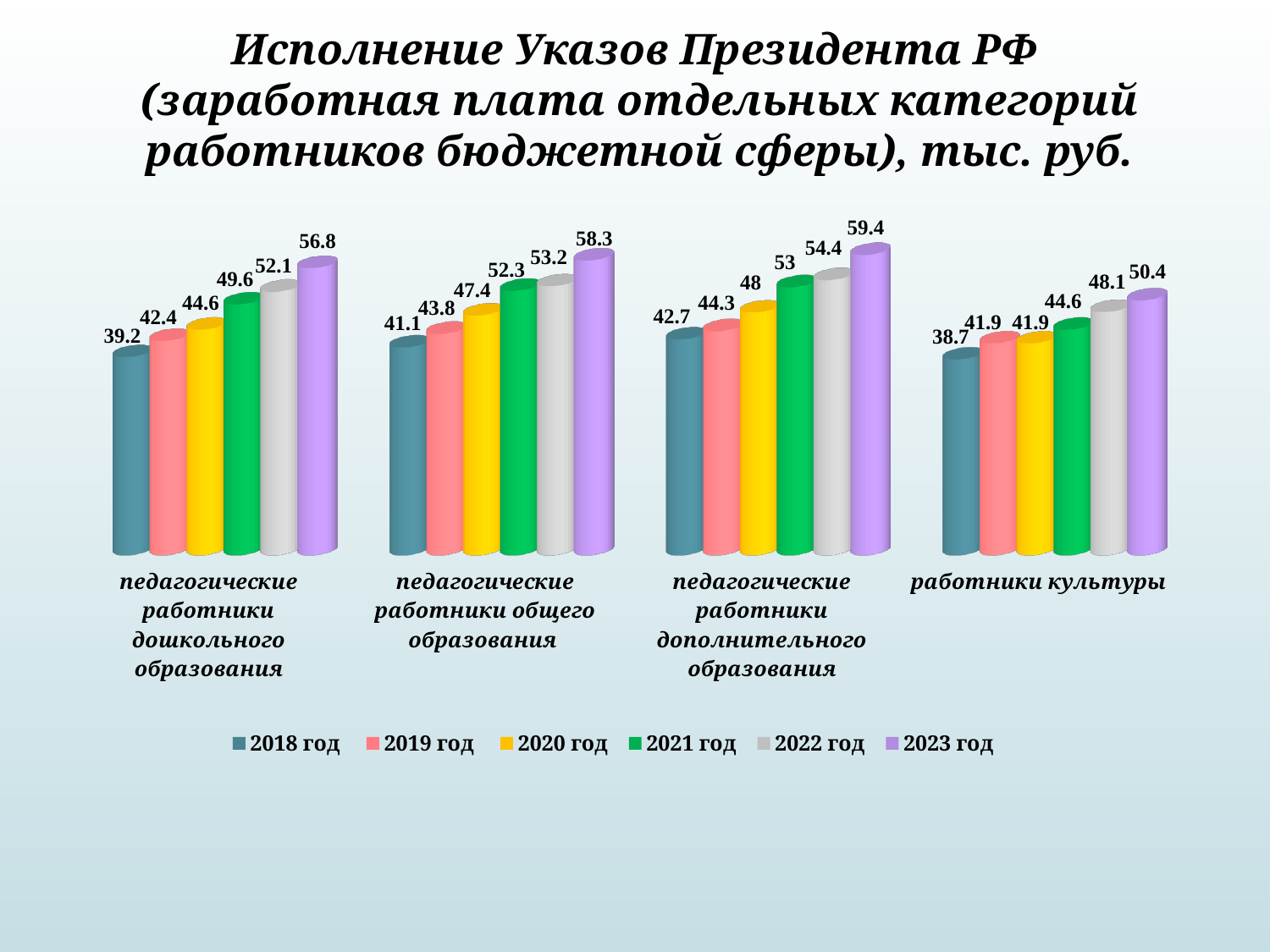
У какой категории работников самое низкое значение за 2018 год? работники культуры Что больше: значение для педагогических работников общего образования за 2022 год или для педагогических работников дошкольного образования за 2022 год? педагогические работники общего образования Какое значение показано для педагогических работников дошкольного образования за 2018 год? 39.2 Как меняются значения для работников культуры с 2018 по 2023 год — растут или падают? растут Сколько рядов (годов) перечислено в легенде диаграммы? 6 Какое значение показано для работников культуры за 2023 год? 50.4 Какое значение показано для педагогических работников общего образования за 2021 год? 52.3 У какой категории работников самое высокое значение за 2023 год? педагогические работники дополнительного образования Каким цветом на диаграмме обозначен 2023 год? фиолетовым (сиреневым) Сколько категорий работников показано на диаграмме? 4 Какого типа эта диаграмма? столбчатая (bar chart) На сколько значение для педагогических работников дополнительного образования за 2023 год больше значения за 2018 год? 16.7